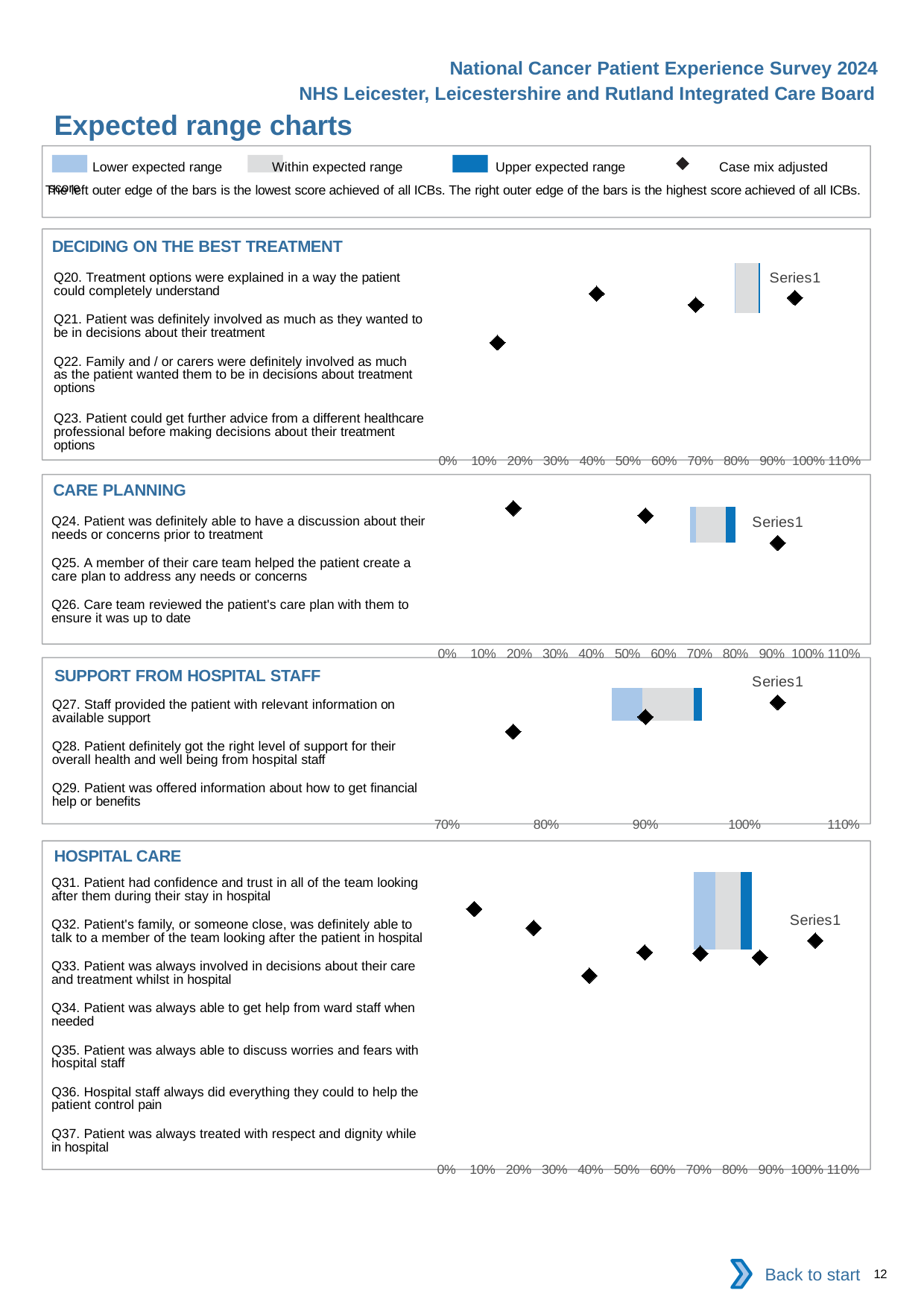
How many case mix adjusted score markers are plotted in the 'SUPPORT FROM HOSPITAL STAFF' chart? 3 How many case mix adjusted score markers are plotted in the 'CARE PLANNING' chart? 3 In the 'DECIDING ON THE BEST TREATMENT' chart, is the leftmost case mix adjusted score marker greater or less than 20%? less What is the lowest axis tick shown on the 'SUPPORT FROM HOSPITAL STAFF' chart? 70% What kind of chart is used in the 'DECIDING ON THE BEST TREATMENT' section? bar chart In the 'CARE PLANNING' chart, is the rightmost case mix adjusted score marker greater or less than 80%? greater How many case mix adjusted score markers are plotted in the 'DECIDING ON THE BEST TREATMENT' chart? 4 In the 'HOSPITAL CARE' chart, is the leftmost case mix adjusted score marker greater or less than 20%? less How many entries does the legend at the top of the slide list? 4 What is the highest axis tick shown on the 'HOSPITAL CARE' chart? 110%